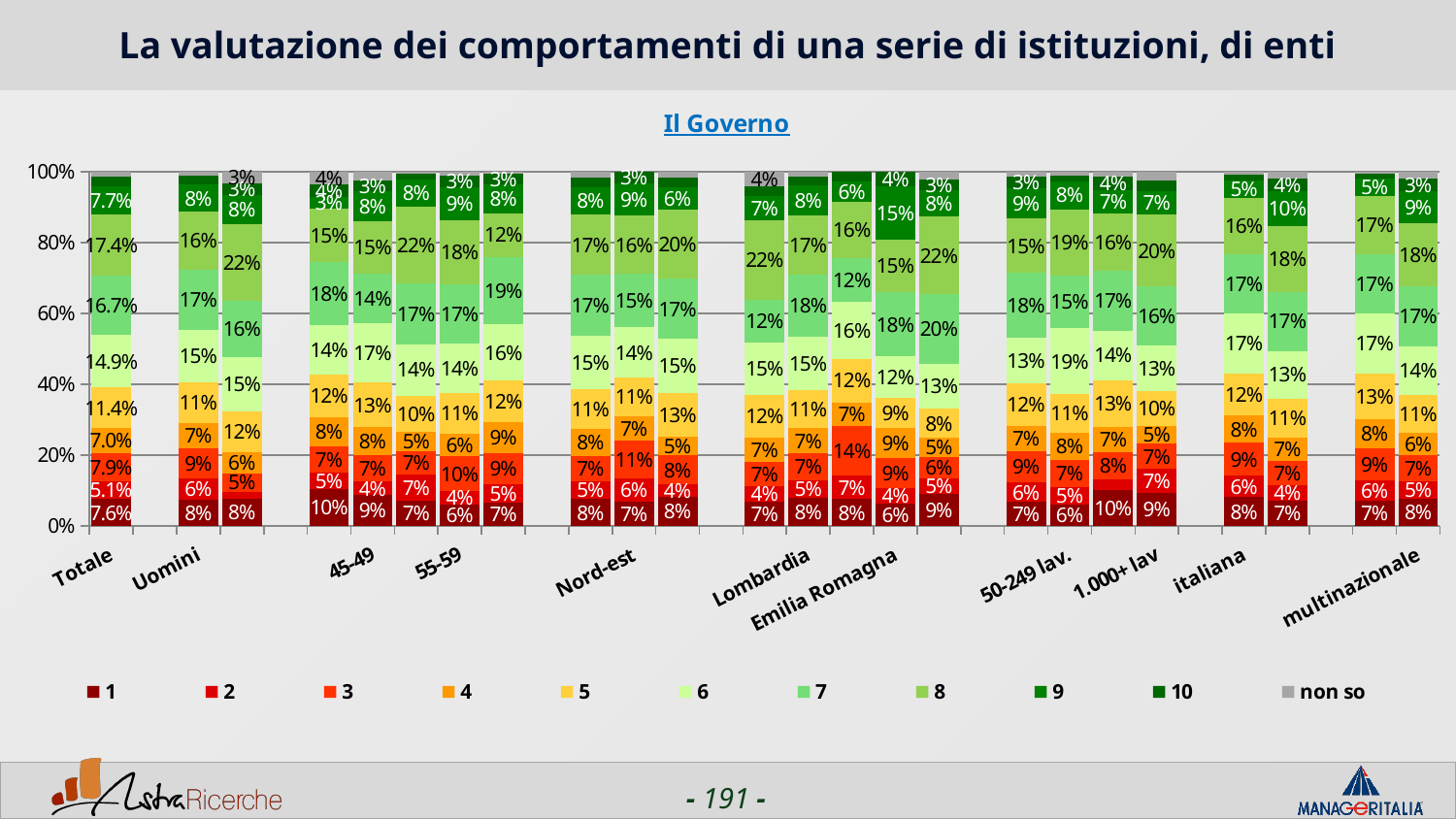
What is the value for series 1 in the Uomini bar? 8% What is the value for series 5 in the Totale bar? 11.4% What is the value for series 1 in the Totale bar? 7.6% In the Totale bar, which is larger: series 6 or series 5? 6 In the Totale bar, which series has the largest share? 8 What kind of chart is shown on the slide? stacked bar chart What is the value for series 8 in the Totale bar? 17.4% How many series does the legend list? 11 What is the last entry in the legend? non so In the Totale bar, what is the difference between series 8 and series 5? 6.0 percentage points What is the value for series 7 in the Uomini bar? 17% What is the title of the chart? Il Governo